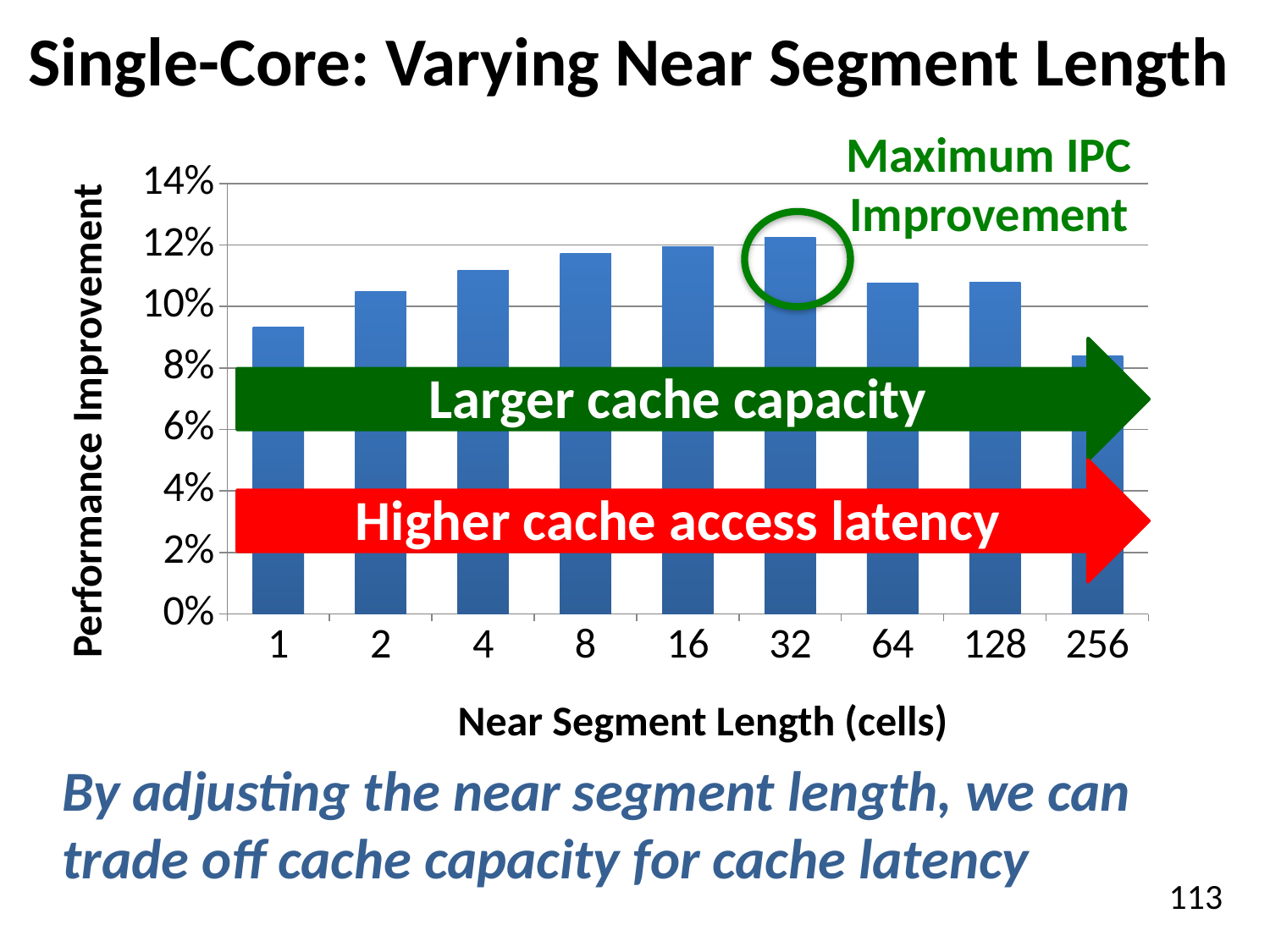
Is the performance improvement for a near segment length of 8 greater or less than 10%? greater Is the performance improvement for a near segment length of 1 greater or less than 10%? less Which has the larger performance improvement, a near segment length of 32 or 256? 32 How many near segment lengths are plotted on the x axis? 9 Which near segment length gives the highest performance improvement? 32 Which near segment length gives the lowest performance improvement? 256 What is the title of the x axis? Near Segment Length (cells) Which has the larger performance improvement, a near segment length of 1 or 2? 2 Do the performance improvement values rise or fall as the near segment length increases from 1 to 32? rise Is the performance improvement for a near segment length of 256 greater or less than 10%? less What kind of chart is shown on the slide? bar chart